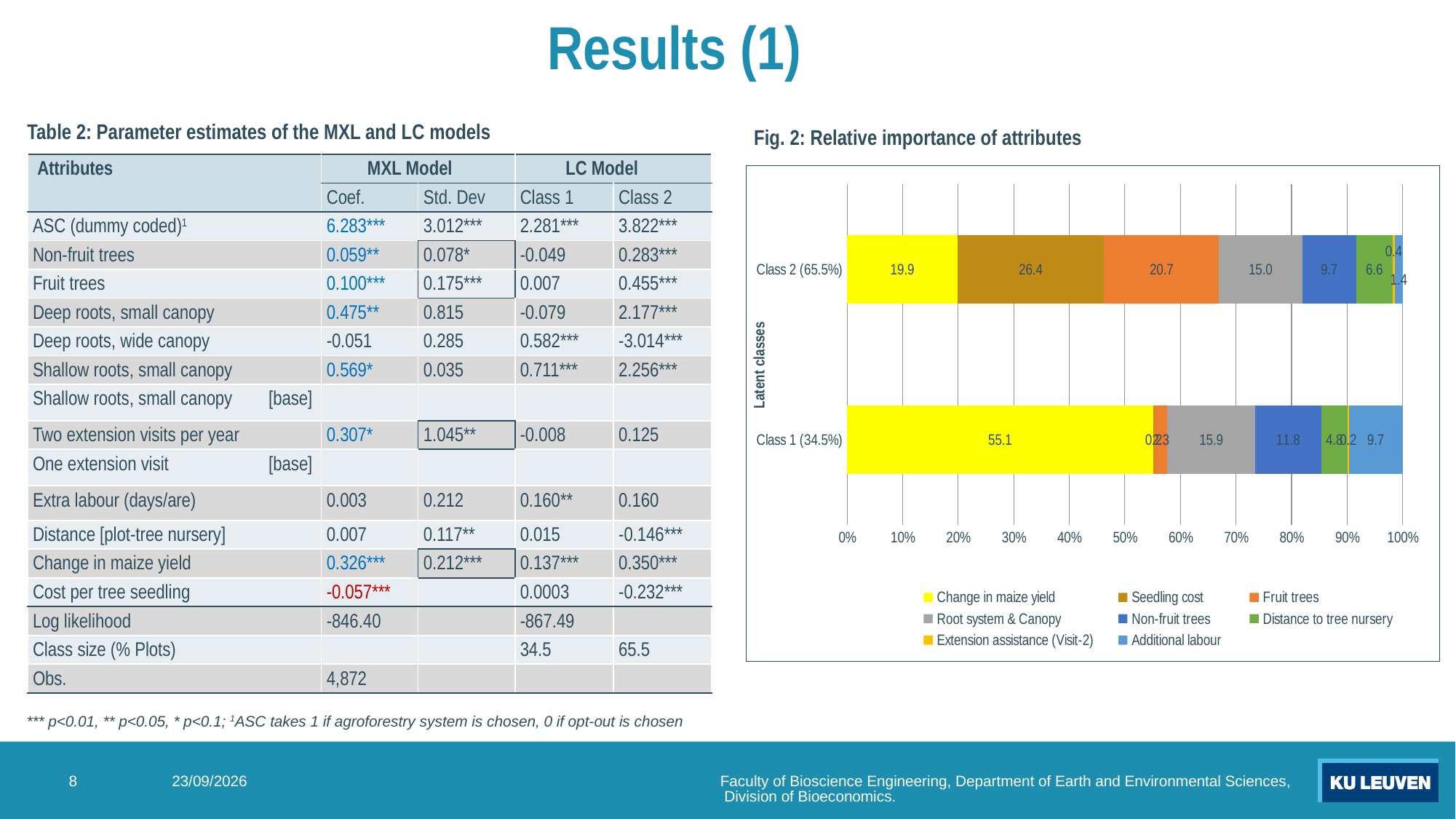
What is the label on the vertical axis of Fig. 2? Latent classes In Fig. 2, what is the value for Fruit trees in Class 2 (65.5%)? 20.7 How many series does the legend of Fig. 2 list? 8 In Fig. 2, what is the difference between the Change in maize yield values for Class 1 (34.5%) and Class 2 (65.5%)? 35.2 What kind of chart is Fig. 2? Stacked bar chart In Fig. 2, for Class 2 (65.5%), which is larger: Seedling cost or Fruit trees? Seedling cost In Fig. 2, which class has the higher value for Change in maize yield? Class 1 (34.5%) In Fig. 2, what is the value for Non-fruit trees in Class 1 (34.5%)? 11.8 How many latent classes are plotted in Fig. 2? 2 In Fig. 2, what is the value for Change in maize yield in Class 1 (34.5%)? 55.1 In Fig. 2, what is the value for Seedling cost in Class 2 (65.5%)? 26.4 In Fig. 2, what is the value for Root system & Canopy in Class 2 (65.5%)? 15.0